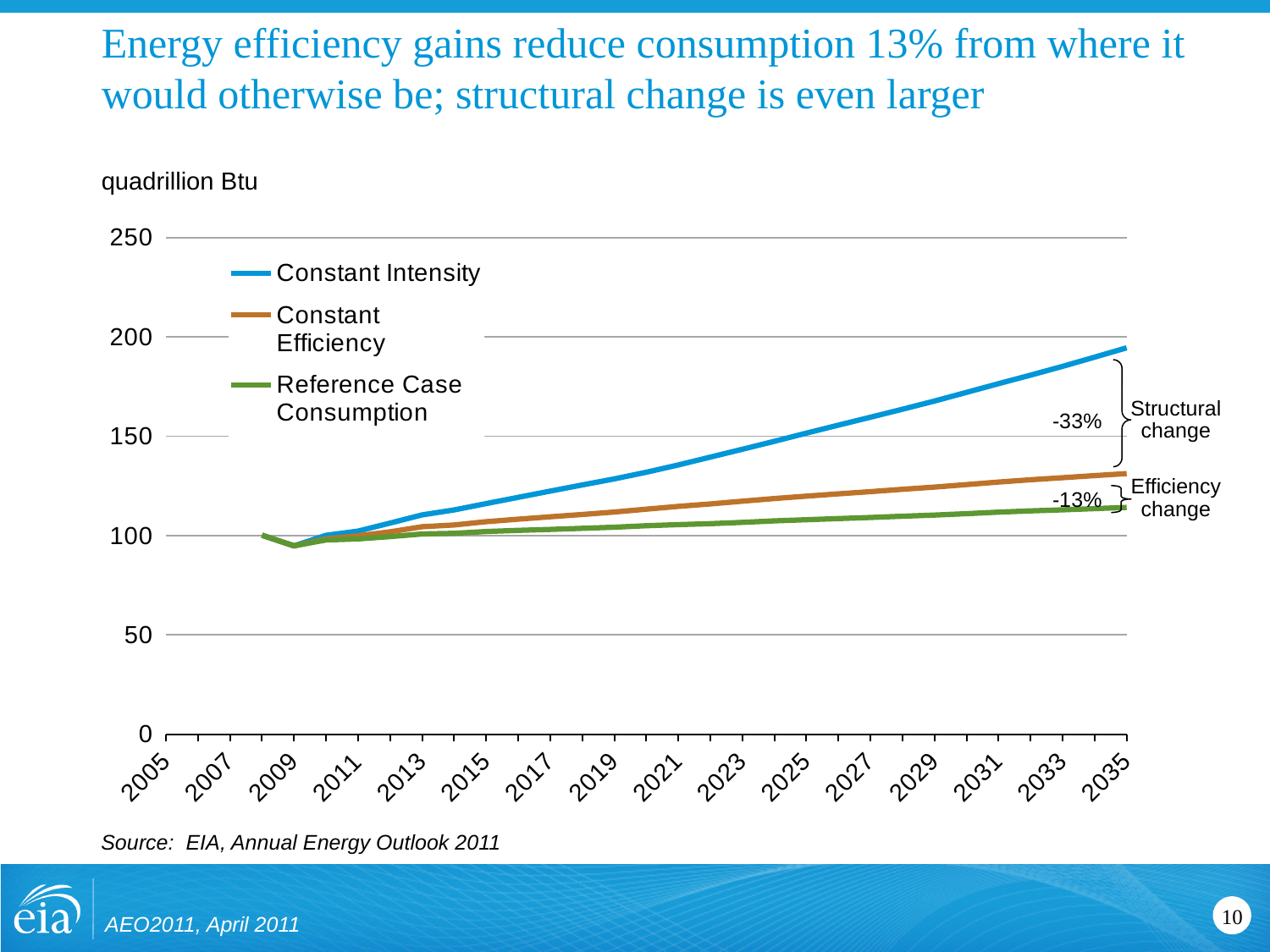
What kind of chart is shown on the slide? line chart Does the Constant Intensity line rise or fall from 2009 to 2035? rise In 2035, which is larger: Constant Efficiency or Reference Case Consumption? Constant Efficiency What percentage change is labelled as the structural change on the chart? -33% Is the value for Constant Efficiency in 2035 greater or less than 150? less Which series has the highest value in 2035? Constant Intensity Is the value for Reference Case Consumption in 2035 greater or less than 100? greater Which series has the lowest value in 2035? Reference Case Consumption How many series does the legend list? 3 Is the value for Constant Intensity in 2035 greater or less than 150? greater What unit is shown for the y axis of the chart? quadrillion Btu